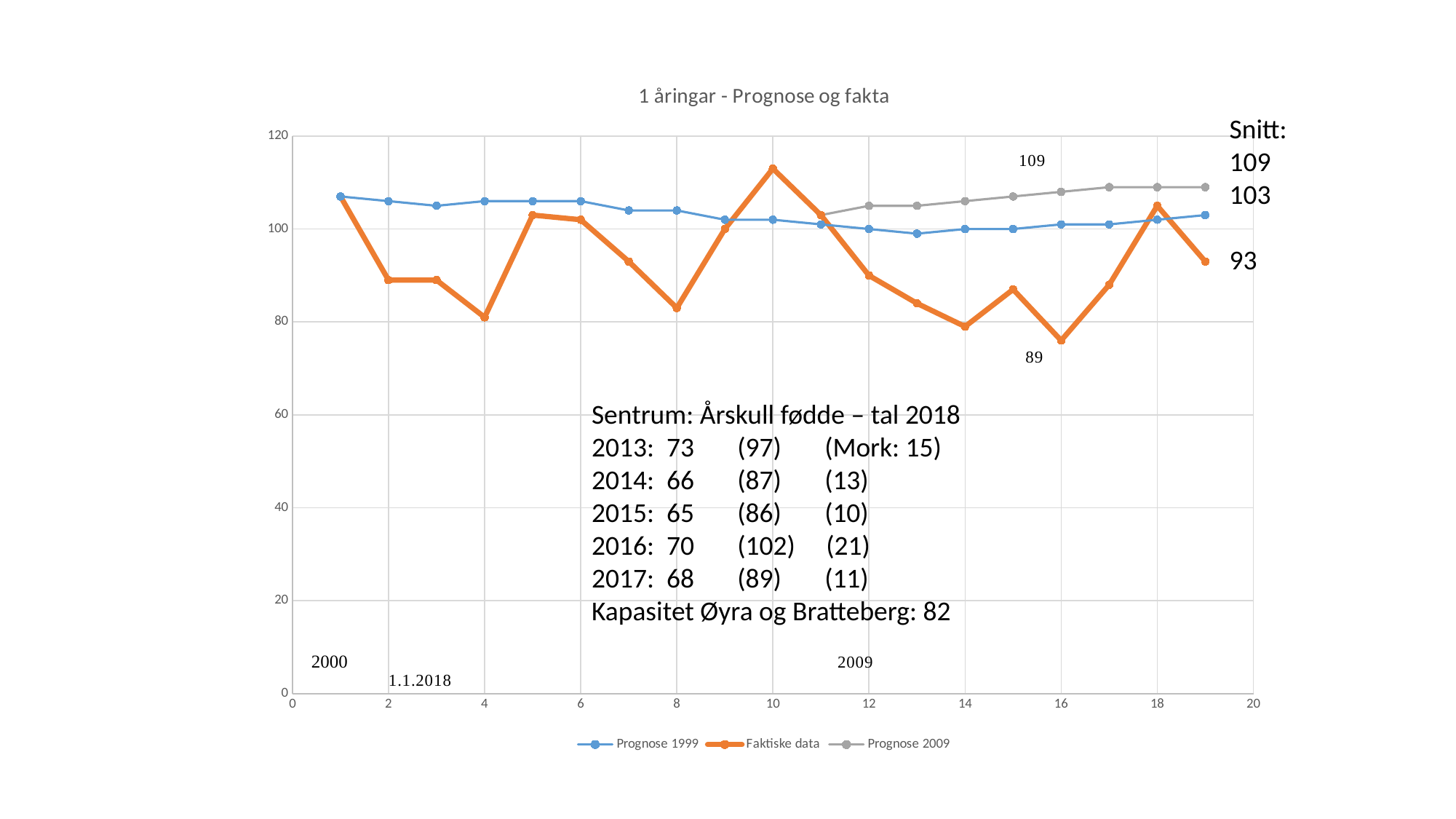
How many series does the legend list? 3 Is the value of Prognose 2009 at x = 19 greater or less than 100? greater What is the title of the chart? 1 åringar - Prognose og fakta Does the Prognose 2009 series generally rise or fall from x = 11 to x = 19? rise At which x value does the Faktiske data series reach its lowest point? 16 What kind of chart is shown on the slide? line chart How many data points does the Prognose 2009 series have? 9 Which series is drawn in orange? Faktiske data At which x value does the Faktiske data series reach its highest point? 10 Is the value of Faktiske data at x = 10 greater or less than 100? greater At x = 14, which series has the larger value, Prognose 1999 or Faktiske data? Prognose 1999 Is the value of Faktiske data at x = 4 greater or less than 100? less